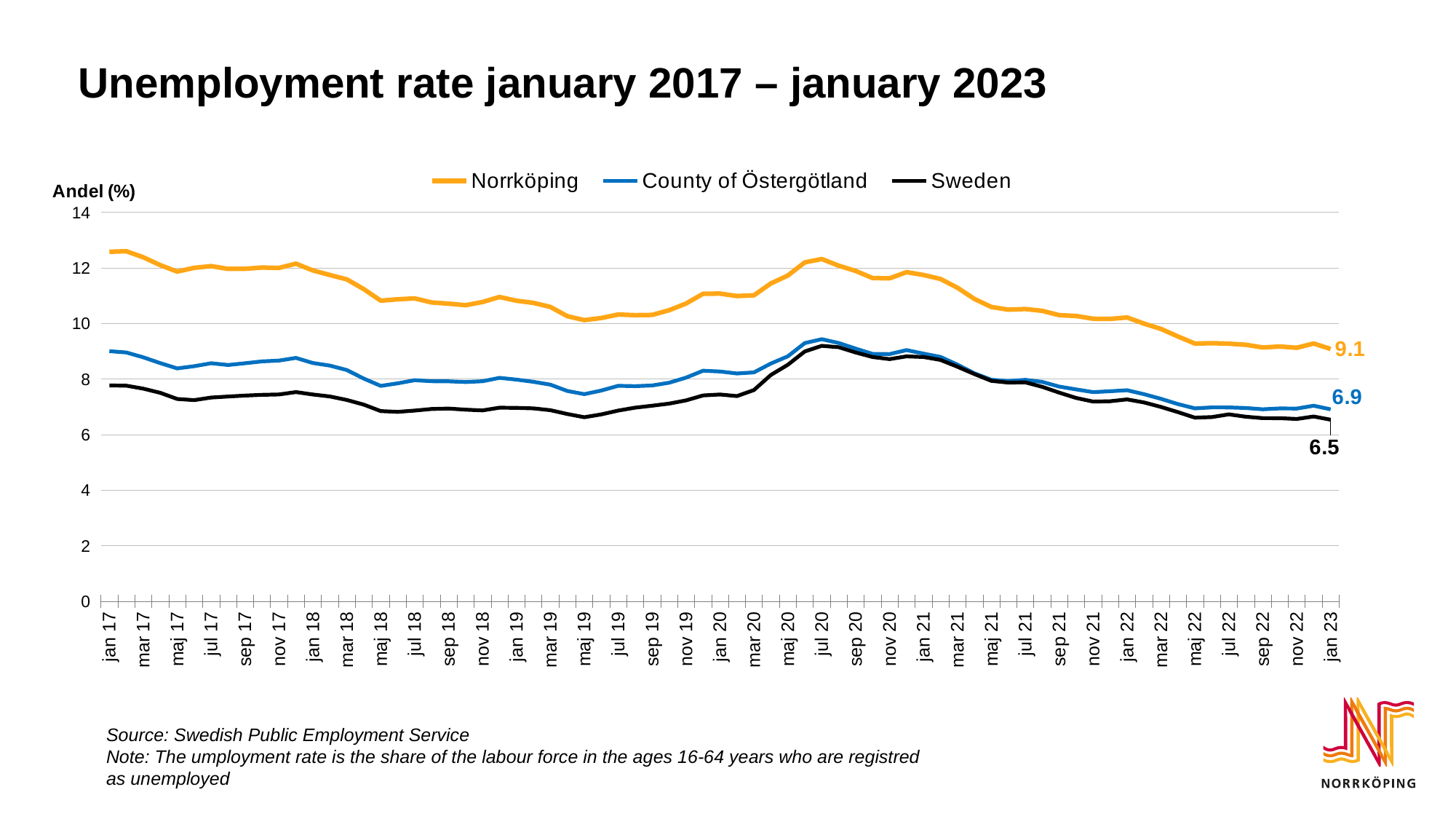
Which series has the highest unemployment rate in jan 23? Norrköping Which series has the lowest unemployment rate in jan 23? Sweden What is the difference between the County of Östergötland and Sweden values in jan 23? 0.4 Does the Norrköping line rise or fall overall from jan 17 to jan 23? Fall What is the unemployment rate for Sweden in jan 23? 6.5 What kind of chart is shown on the slide? Line chart Is the value for Sweden in jul 20 greater or less than 8? greater What is the difference between the Norrköping and Sweden values in jan 23? 2.6 Is the value for Norrköping in jan 17 greater or less than 12? greater What is the unemployment rate for Norrköping in jan 23? 9.1 What is the unemployment rate for County of Östergötland in jan 23? 6.9 How many series does the legend list? 3